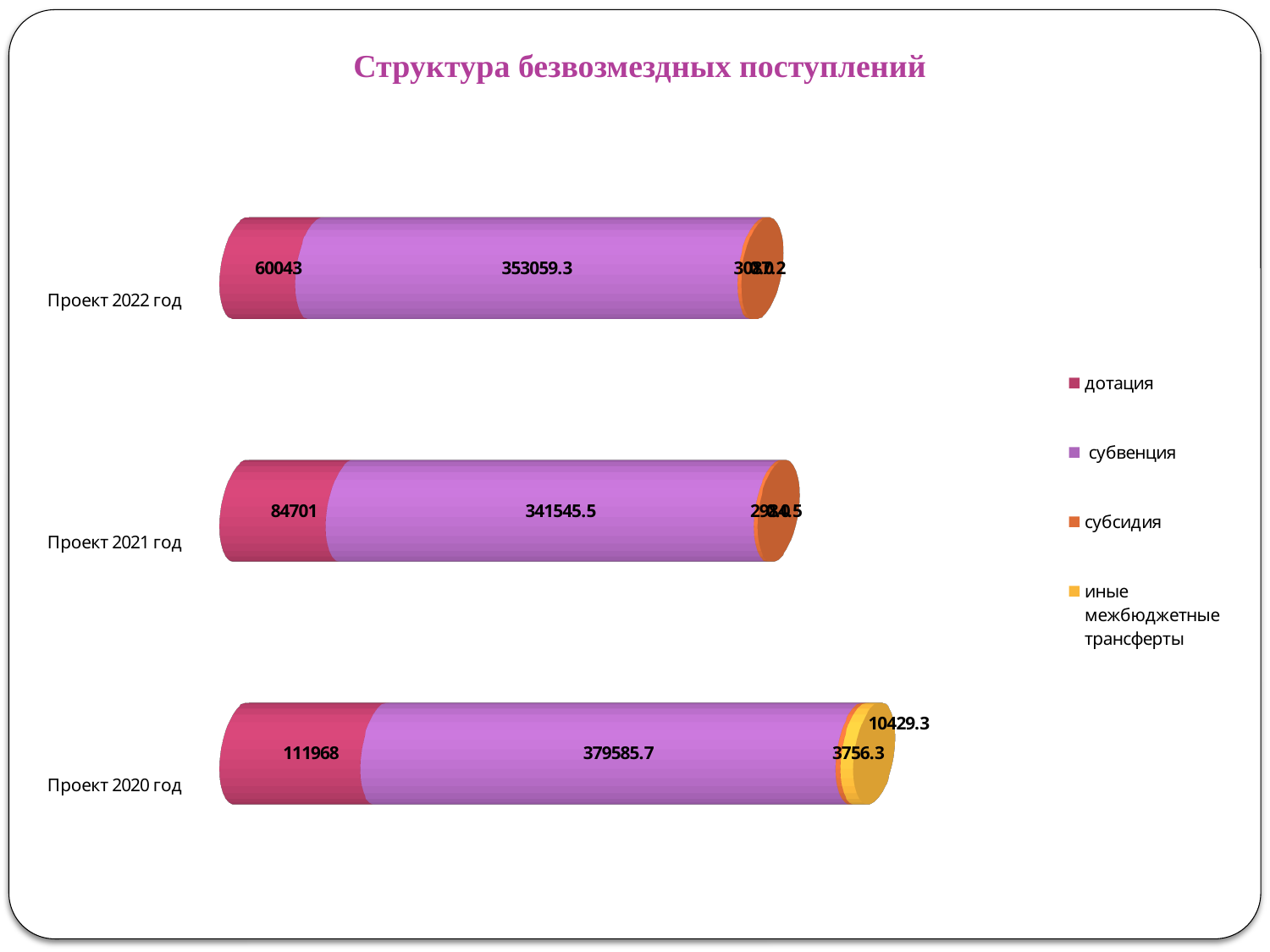
How many categories (years) are shown on the chart? 3 How many series does the legend list? 4 Does the value of дотация rise or fall from Проект 2020 год to Проект 2022 год? Fall What is the value of дотация for Проект 2020 год? 111968 What is the value of субвенция for Проект 2020 год? 379585.7 Which category has the highest value of дотация? Проект 2020 год What is the title of the chart? Структура безвозмездных поступлений What is the difference between дотация for Проект 2021 год and Проект 2022 год? 24658 Which is larger: субвенция for Проект 2022 год or for Проект 2021 год? Проект 2022 год What is the value of дотация for Проект 2022 год? 60043 What is the value of субвенция for Проект 2021 год? 341545.5 What kind of chart is shown on the slide? Stacked bar chart